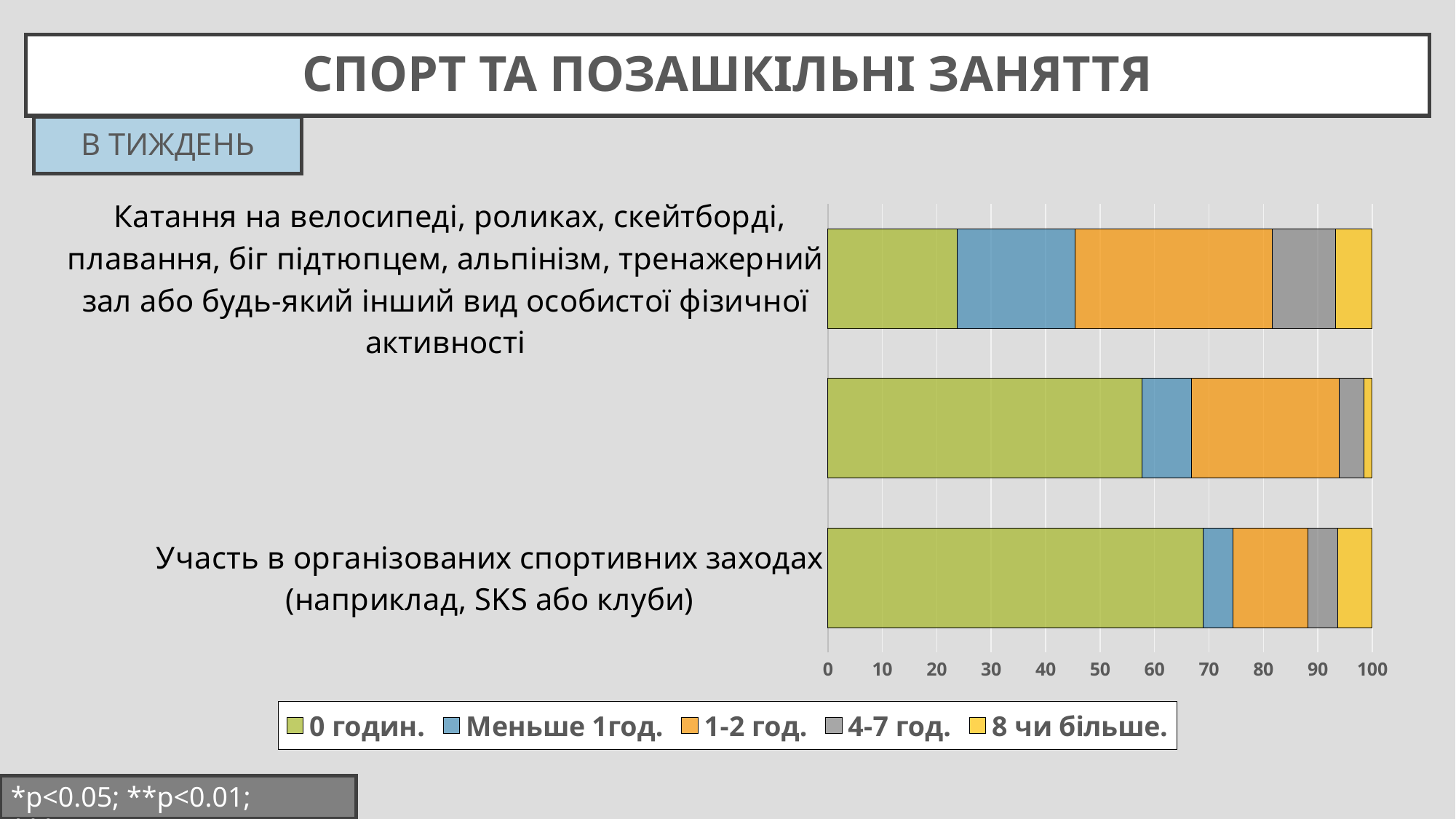
Which series has the largest segment in the bar for "Участь в організованих спортивних заходах (наприклад, SKS або клуби)"? 0 годин. Which category has the larger "0 годин." segment: "Катання на велосипеді..." or "Участь в організованих спортивних заходах (наприклад, SKS або клуби)"? Участь в організованих спортивних заходах (наприклад, SKS або клуби) Is the value of "0 годин." for "Участь в організованих спортивних заходах (наприклад, SKS або клуби)" greater or less than 60? greater What is the first entry listed in the legend? 0 годин. How many series does the legend list? 5 Which legend entry is shown in yellow? 8 чи більше. Is the value of "0 годин." for "Катання на велосипеді, роликах, скейтборді, плавання, біг підтюпцем, альпінізм, тренажерний зал або будь-який інший вид особистої фізичної активності" greater or less than 30? less What kind of chart is shown on the slide? stacked bar chart Is the value of "Меньше 1год." for "Участь в організованих спортивних заходах (наприклад, SKS або клуби)" greater or less than 10? less Which series has the largest segment in the bar for "Катання на велосипеді, роликах, скейтборді, плавання, біг підтюпцем, альпінізм, тренажерний зал або будь-який інший вид особистої фізичної активності"? 1-2 год. How many bars are plotted in the chart? 3